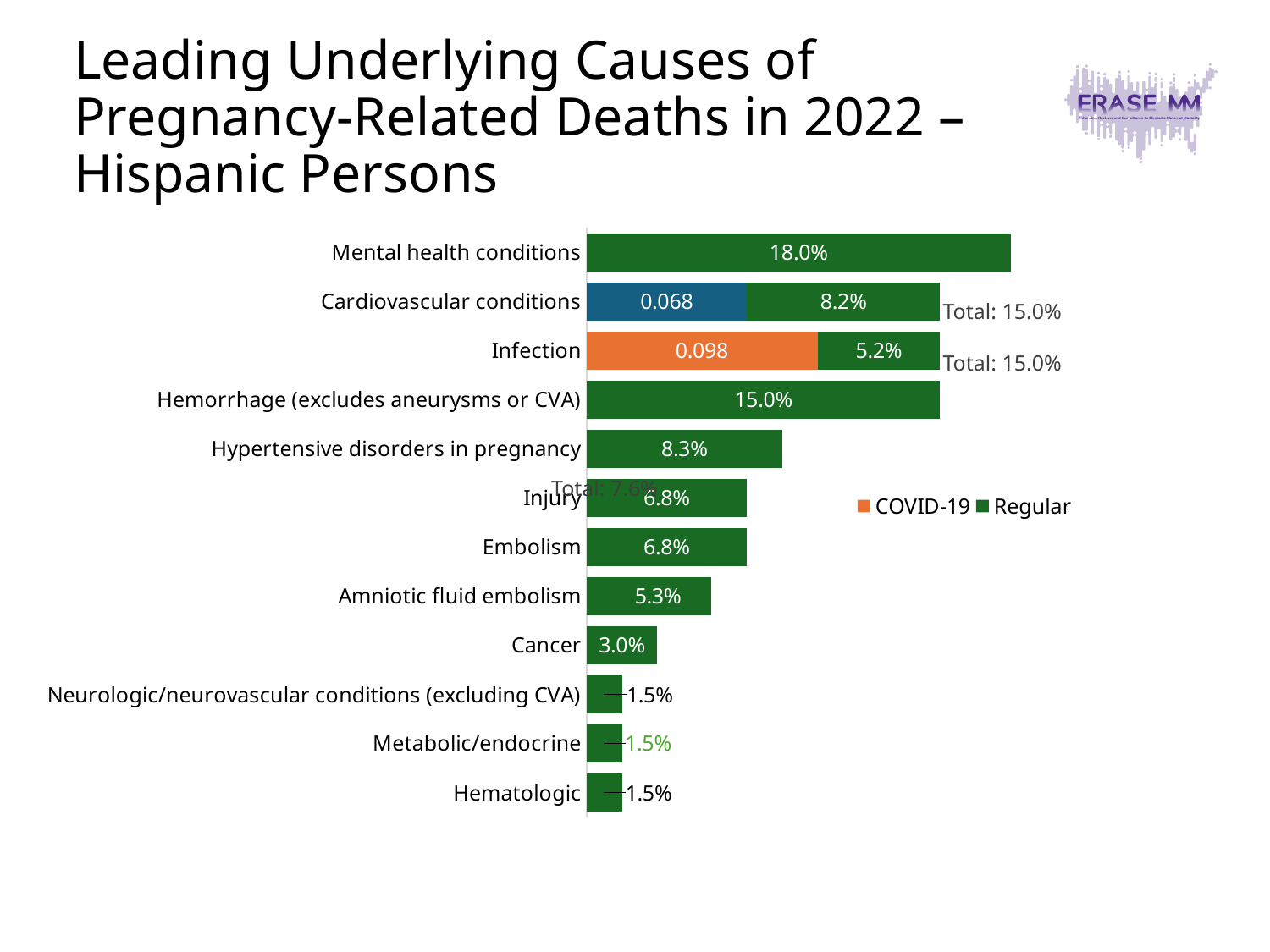
What is the Regular value shown for Cardiovascular conditions? 8.2% What is the value shown for Mental health conditions? 18.0% Which category has the highest value? Mental health conditions What is the value shown for Hemorrhage (excludes aneurysms or CVA)? 15.0% What is the value shown for Hypertensive disorders in pregnancy? 8.3% What is the Regular value shown for Infection? 5.2% How many series does the legend list? 2 What kind of chart is shown on the slide? bar chart What is the total shown for the Infection bar? 15.0% What is the value shown for Cancer? 3.0% How many categories are shown on the chart? 12 Which is larger, the value for Amniotic fluid embolism or the value for Cancer? Amniotic fluid embolism